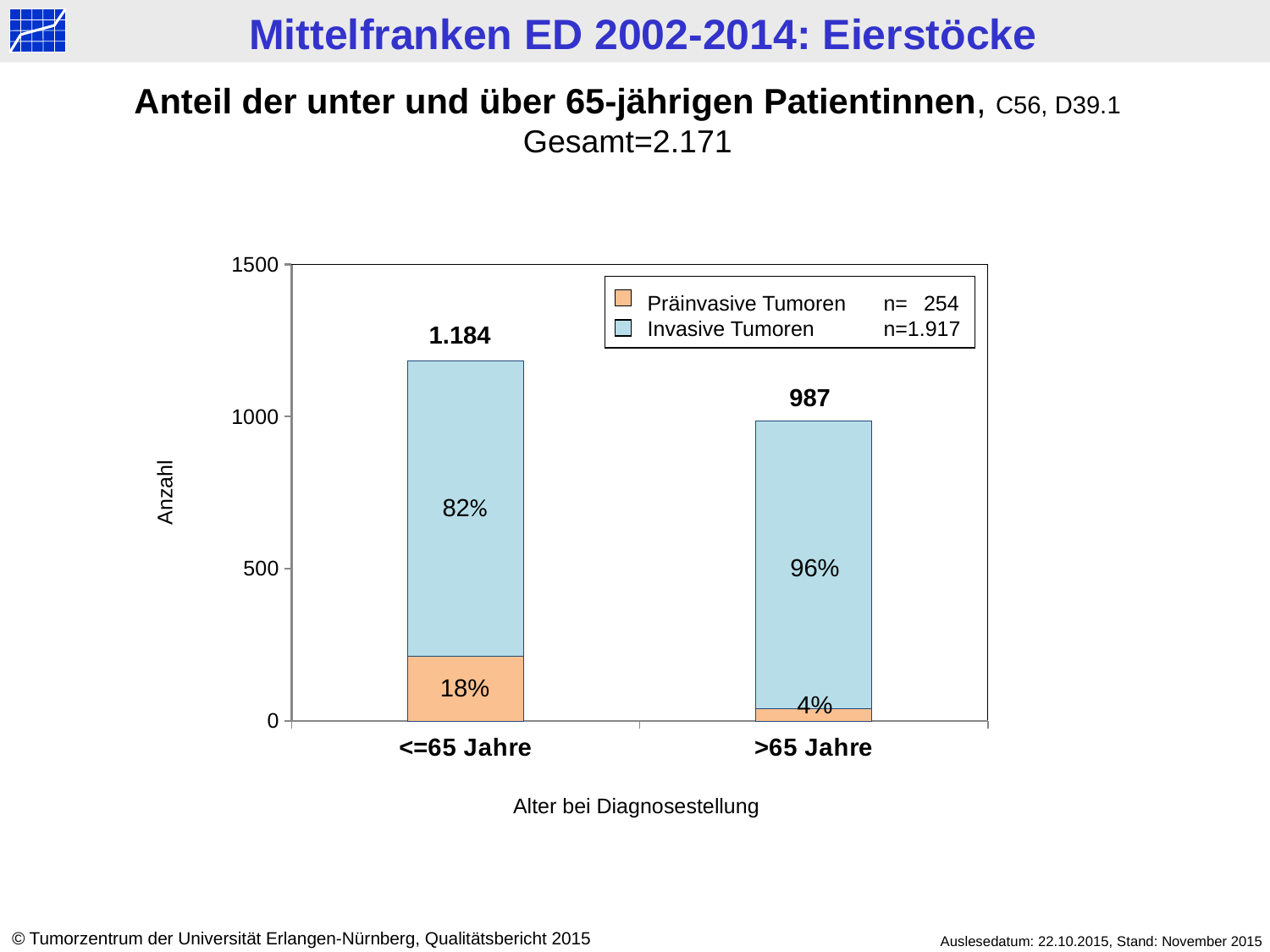
What percentage of the <=65 Jahre bar is Invasive Tumoren? 82% What is the total shown above the bar for <=65 Jahre? 1.184 What is the total shown above the bar for >65 Jahre? 987 Which age group has the higher total number of patients? <=65 Jahre How many age categories are shown on the x axis? 2 According to the legend, what is n for Invasive Tumoren? 1.917 What kind of chart is shown on the slide? Stacked bar chart What percentage of the >65 Jahre bar is Präinvasive Tumoren? 4% What percentage of the >65 Jahre bar is Invasive Tumoren? 96% What percentage of the <=65 Jahre bar is Präinvasive Tumoren? 18% How many series does the legend list? 2 What is the difference between the totals for <=65 Jahre and >65 Jahre? 197